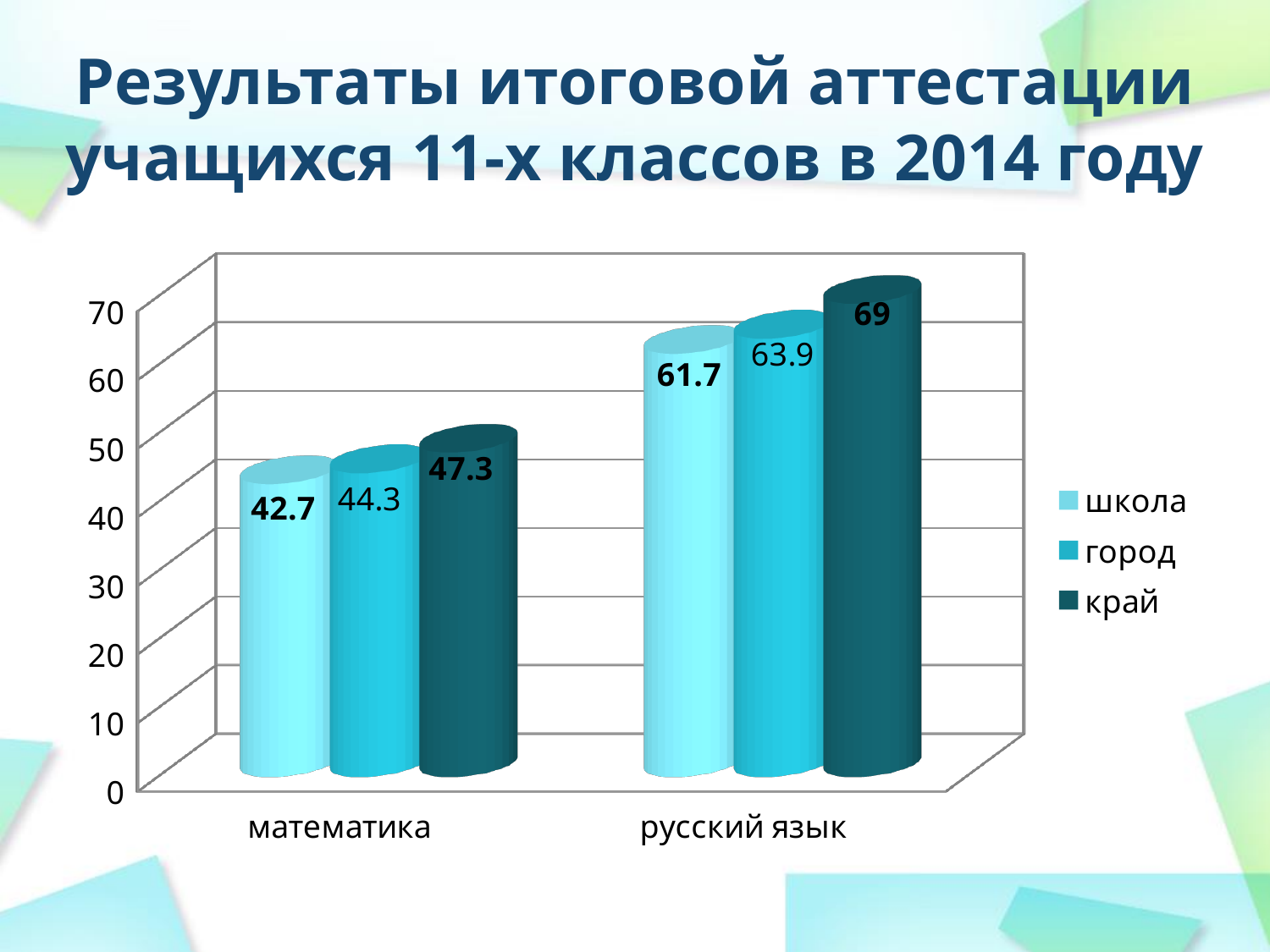
What is the value for город in русский язык? 63.9 What is the value for школа in математика? 42.7 How many series does the legend list? 3 What kind of chart is shown on the slide? bar chart Which series has the highest value in русский язык? край Which is larger: the школа value in русский язык or the край value in математика? школа value in русский язык What is the difference between the край and школа values in математика? 4.6 Which series has the lowest value in математика? школа What is the difference between the край and город values in русский язык? 5.1 How many categories are shown on the x axis? 2 What is the value for город in математика? 44.3 What is the value for край in русский язык? 69